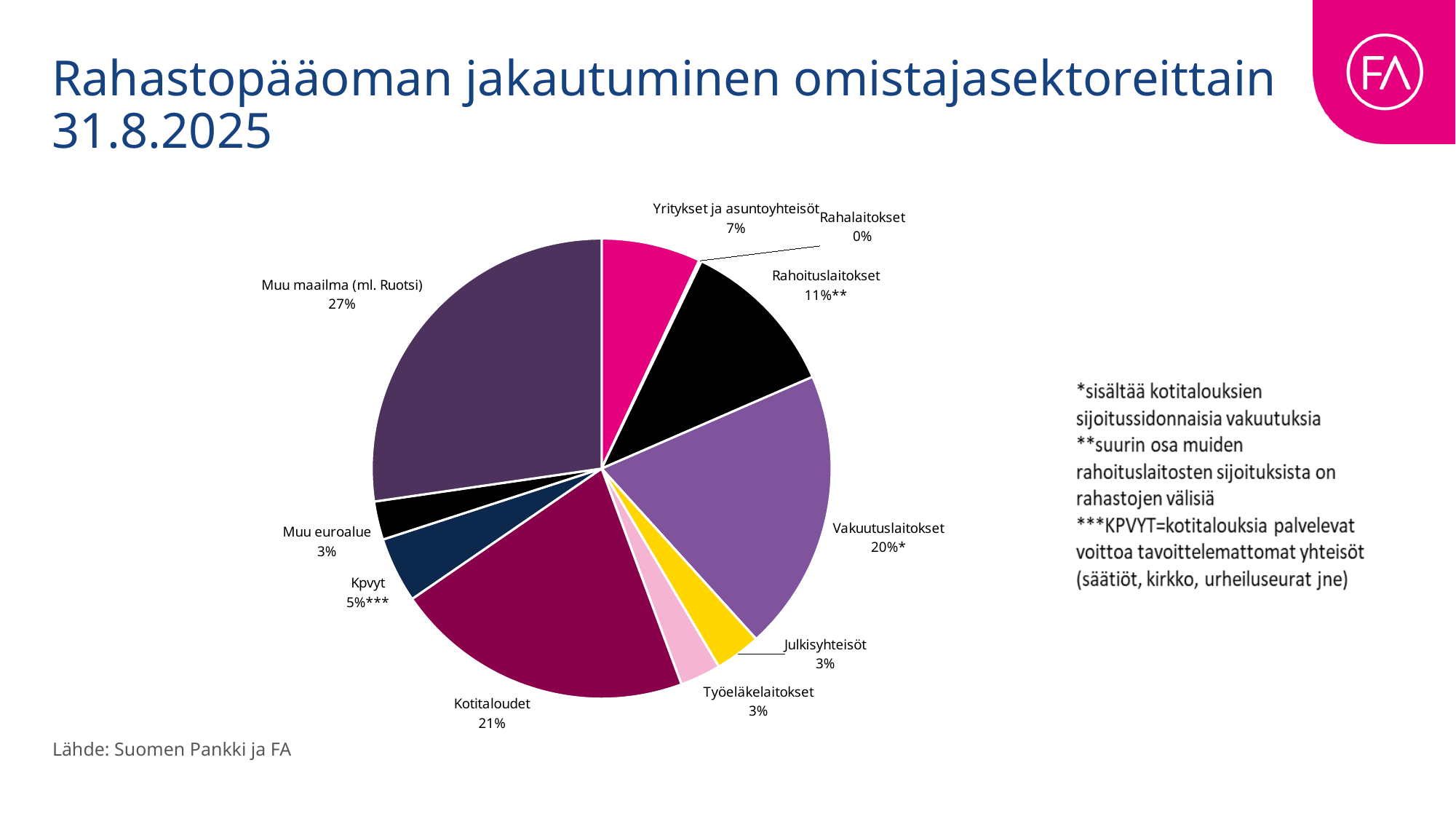
Which sector has the smallest share of the pie? Rahalaitokset How many sectors (slices) are labelled in the pie chart? 10 What kind of chart is shown on the slide? pie chart Which has the larger share, Kotitaloudet or Vakuutuslaitokset? Kotitaloudet What is the value shown for Rahoituslaitokset? 11% What is the value shown for Kotitaloudet? 21% What is the value shown for Kpvyt? 5% How many percentage points larger is the share of Muu maailma (ml. Ruotsi) than that of Kotitaloudet? 6 What is the value shown for Vakuutuslaitokset? 20% What is the value shown for Yritykset ja asuntoyhteisöt? 7% What share of the pie does Muu maailma (ml. Ruotsi) hold? 27% Which sector has the largest share of the pie? Muu maailma (ml. Ruotsi)